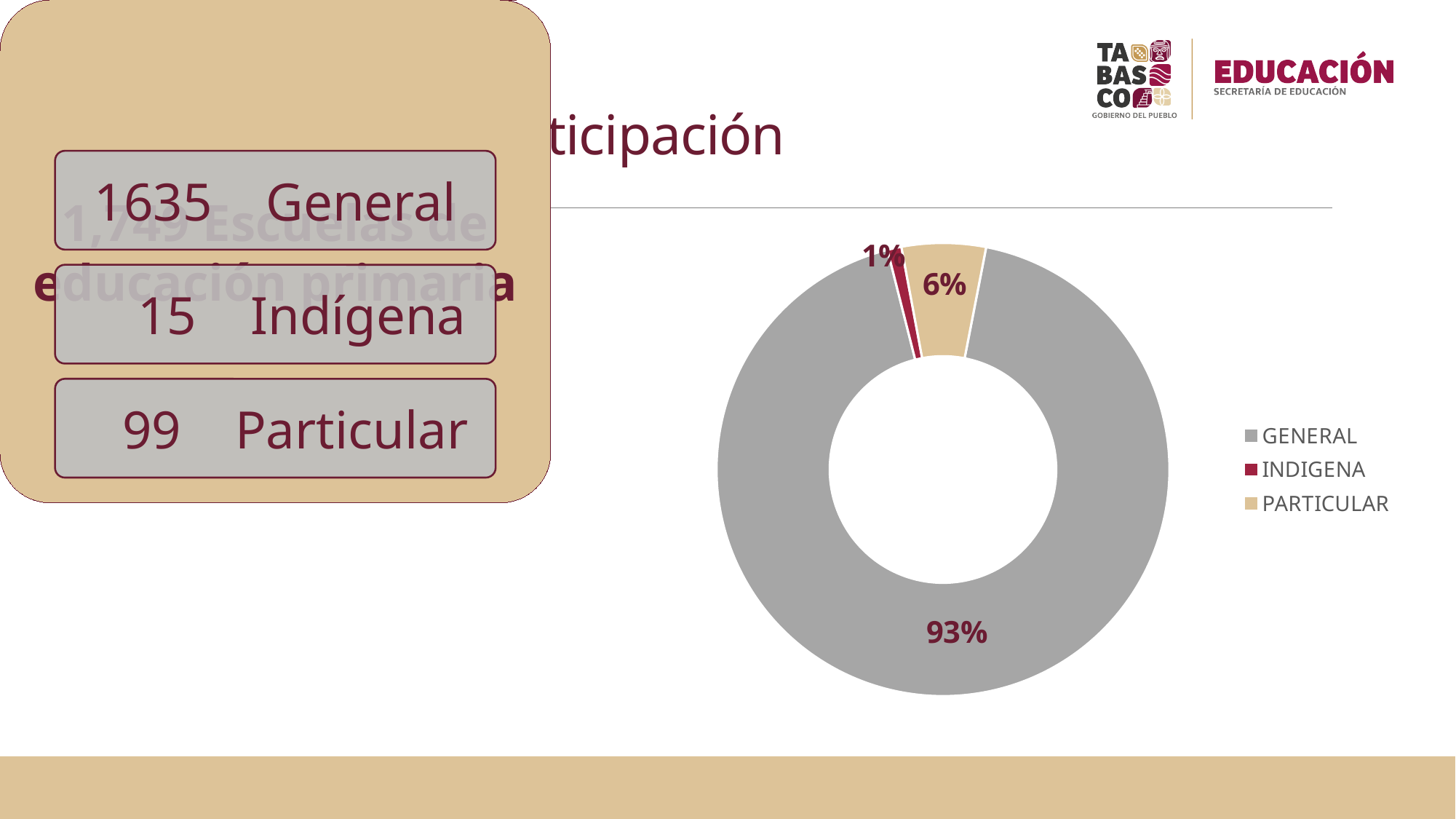
What is the difference in percentage points between the PARTICULAR and INDIGENA slices? 5 What kind of chart is shown on the slide? Doughnut (pie) chart What percentage share does the PARTICULAR slice have in the chart? 6% What colour is the INDIGENA slice in the chart? Dark red Which category has the smallest slice in the chart? INDIGENA How many categories does the chart's legend list? 3 Which slice is larger, PARTICULAR or INDIGENA? PARTICULAR What percentage share does the INDIGENA slice have in the chart? 1% What colour is the GENERAL slice in the chart? Gray What is the difference in percentage points between the GENERAL and PARTICULAR slices? 87 What percentage share does the GENERAL slice have in the chart? 93% Which category has the largest slice in the chart? GENERAL